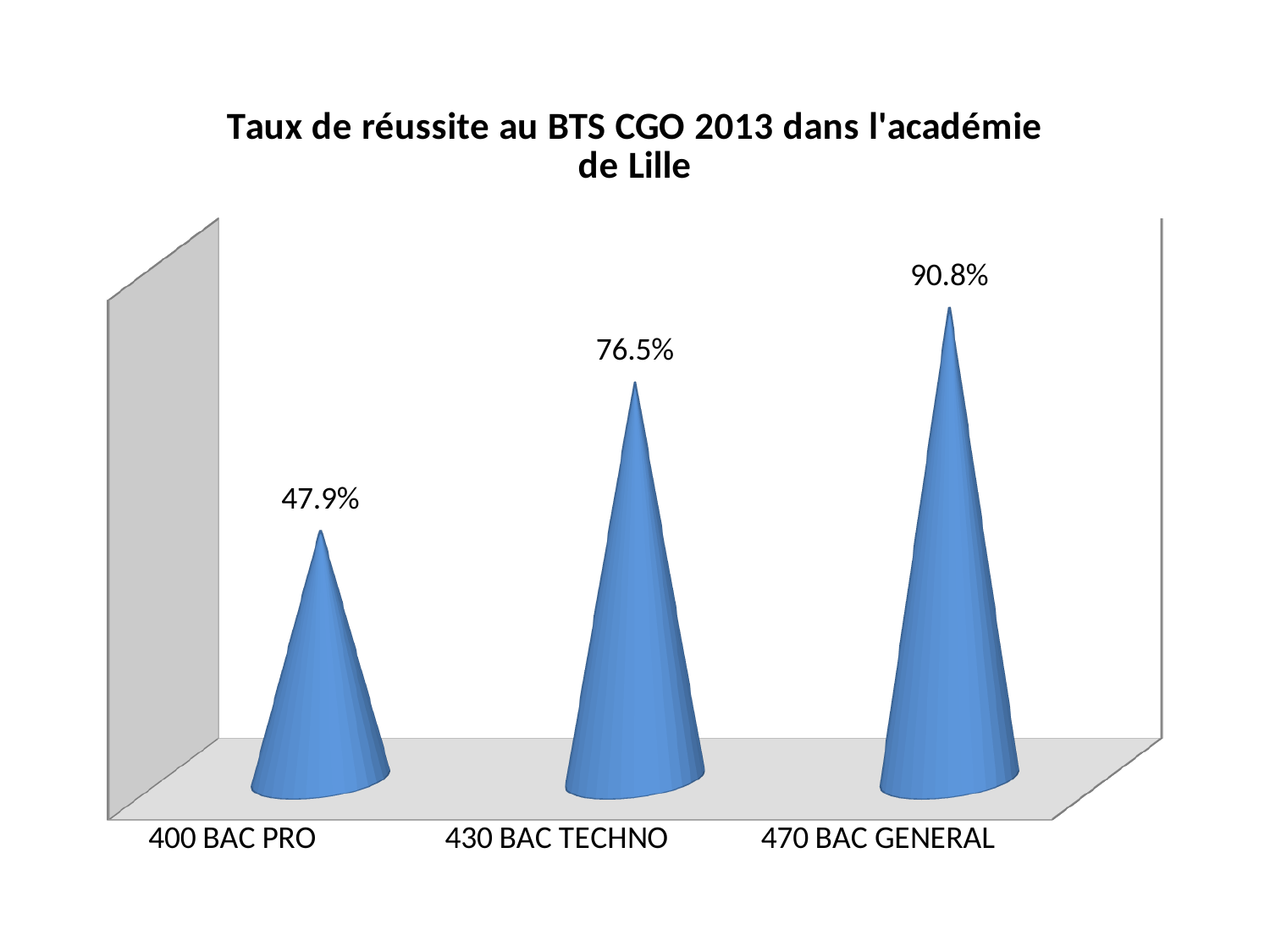
Which has a higher success rate, 430 BAC TECHNO or 470 BAC GENERAL? 470 BAC GENERAL What kind of chart is this? bar chart Do the values rise or fall from left to right across the categories? rise What is the success rate for 470 BAC GENERAL? 90.8% What is the success rate for 430 BAC TECHNO? 76.5% What is the title of the chart? Taux de réussite au BTS CGO 2013 dans l'académie de Lille What is the difference between the success rates of 430 BAC TECHNO and 400 BAC PRO? 28.6% What is the success rate for 400 BAC PRO? 47.9% Which category has the lowest success rate? 400 BAC PRO Which category has the highest success rate? 470 BAC GENERAL How many categories are shown in the chart? 3 What is the difference between the success rates of 470 BAC GENERAL and 400 BAC PRO? 42.9%